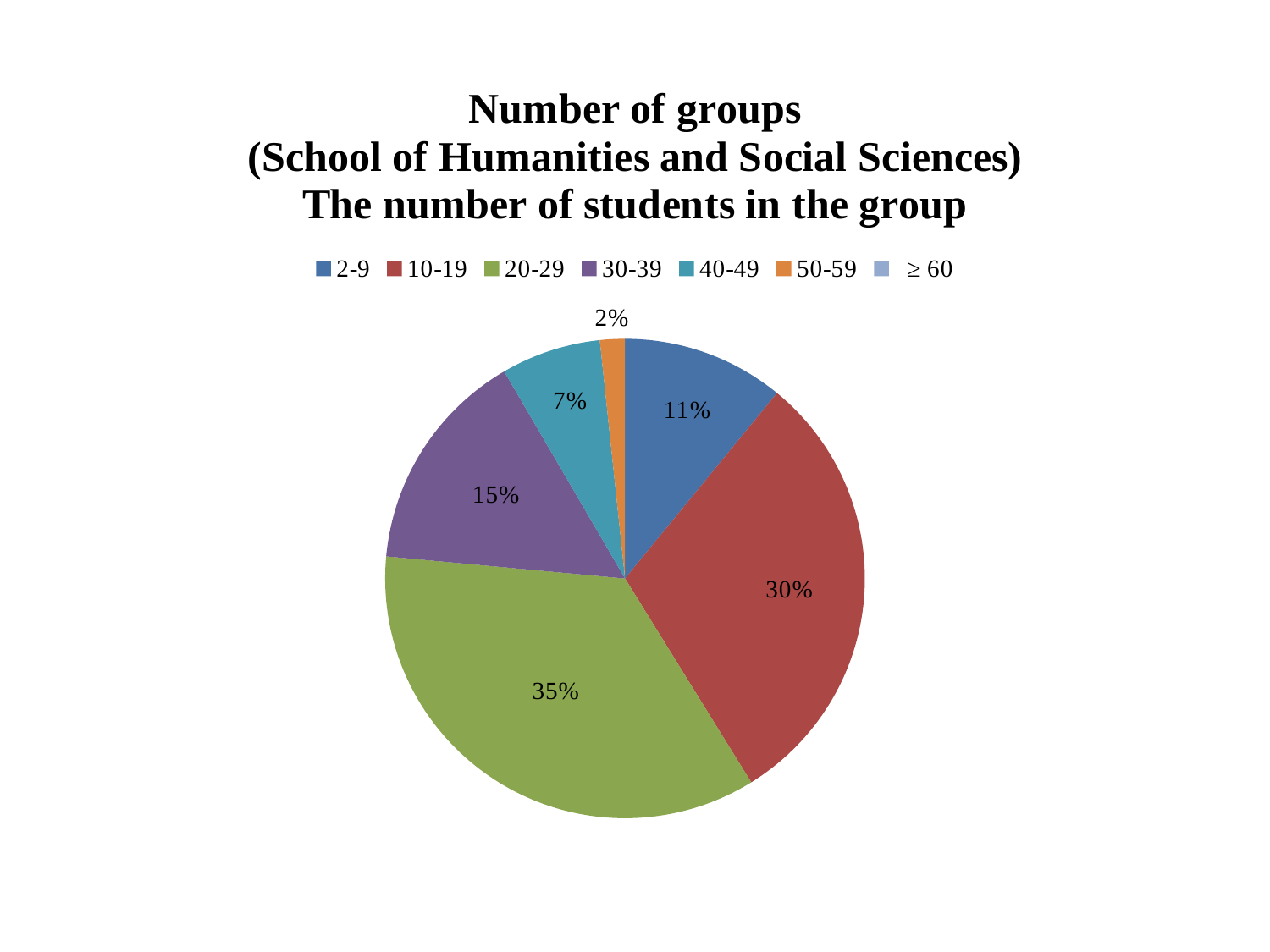
What percentage is shown for the 30-39 category? 15% What is the difference in percentage points between the 20-29 slice and the 10-19 slice? 5 What kind of chart is shown on the slide? Pie chart What percentage is shown for the 40-49 category? 7% Which category has the largest slice of the pie? 20-29 What percentage is shown for the 50-59 category? 2% Which of the labeled slices is the smallest? 50-59 How many entries does the legend list? 7 What share of the pie does the 20-29 group account for? 35% What percentage is shown for the 10-19 category? 30% What percentage is shown for the 2-9 category? 11% Which is larger, the 10-19 slice or the 30-39 slice? 10-19